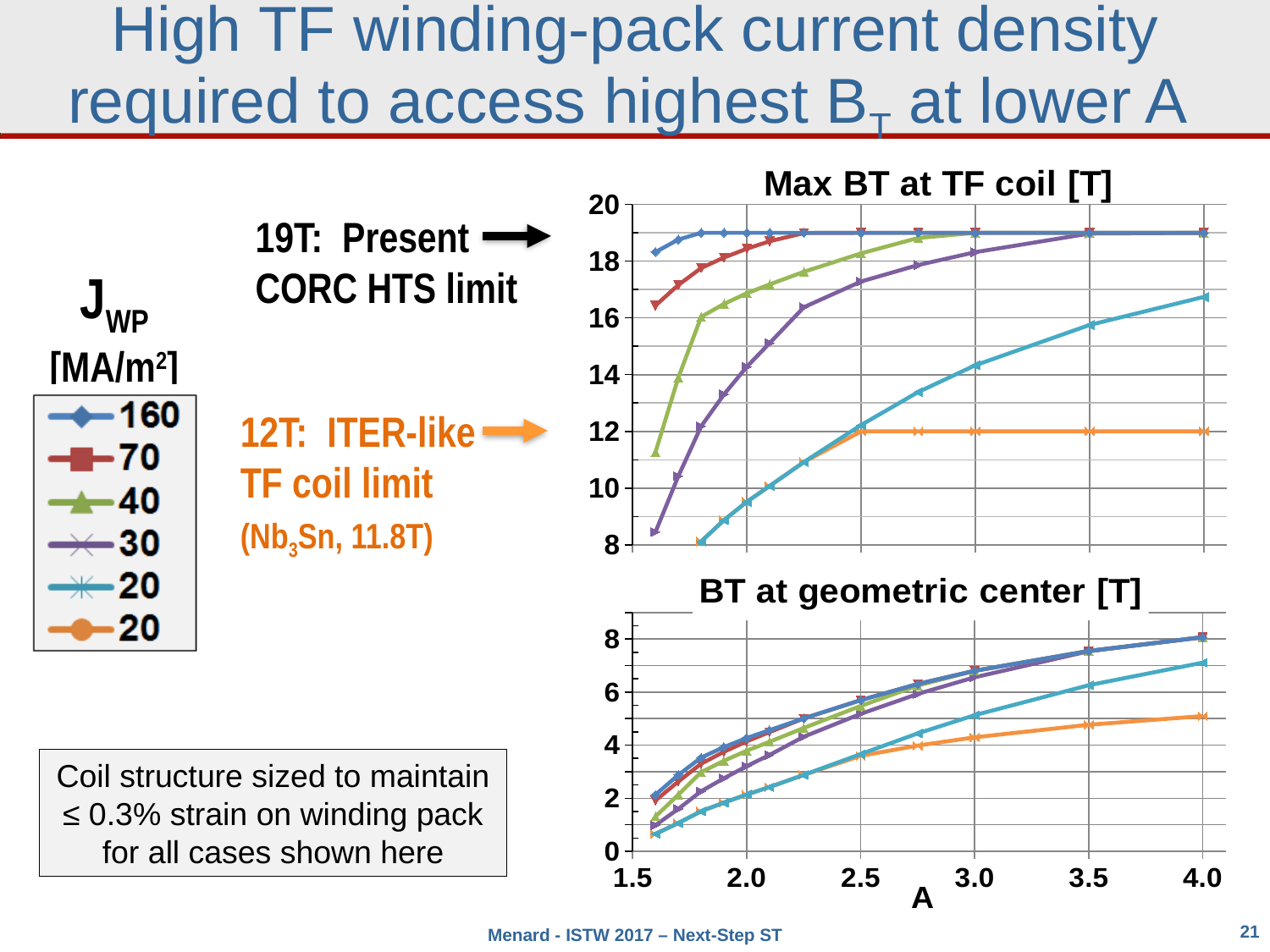
In the "Max BT at TF coil [T]" chart, is the value of the 30 series at A = 1.6 greater or less than 10? less In the "BT at geometric center [T]" chart, at A = 4.0, which is larger: the teal 20 series or the orange 20 series? teal 20 series In the "BT at geometric center [T]" chart, is the value of the teal 20 series at A = 1.6 greater or less than 2? less What is the label of the x axis shared by the two charts? A In the "BT at geometric center [T]" chart, is the value of the orange 20 series at A = 4.0 greater or less than 4? greater In the "Max BT at TF coil [T]" chart, at A = 4.0, which is larger: the teal 20 series or the orange 20 series? teal 20 series In the "Max BT at TF coil [T]" chart, what value does the orange 20 series plateau at from A = 2.5 onward? 12 In the "BT at geometric center [T]" chart, do the values rise or fall as A increases? rise How many series does the legend list for the charts? 6 In the "Max BT at TF coil [T]" chart, which series has the highest value at A = 1.6? 160 What kind of chart is the top chart titled "Max BT at TF coil [T]"? line chart